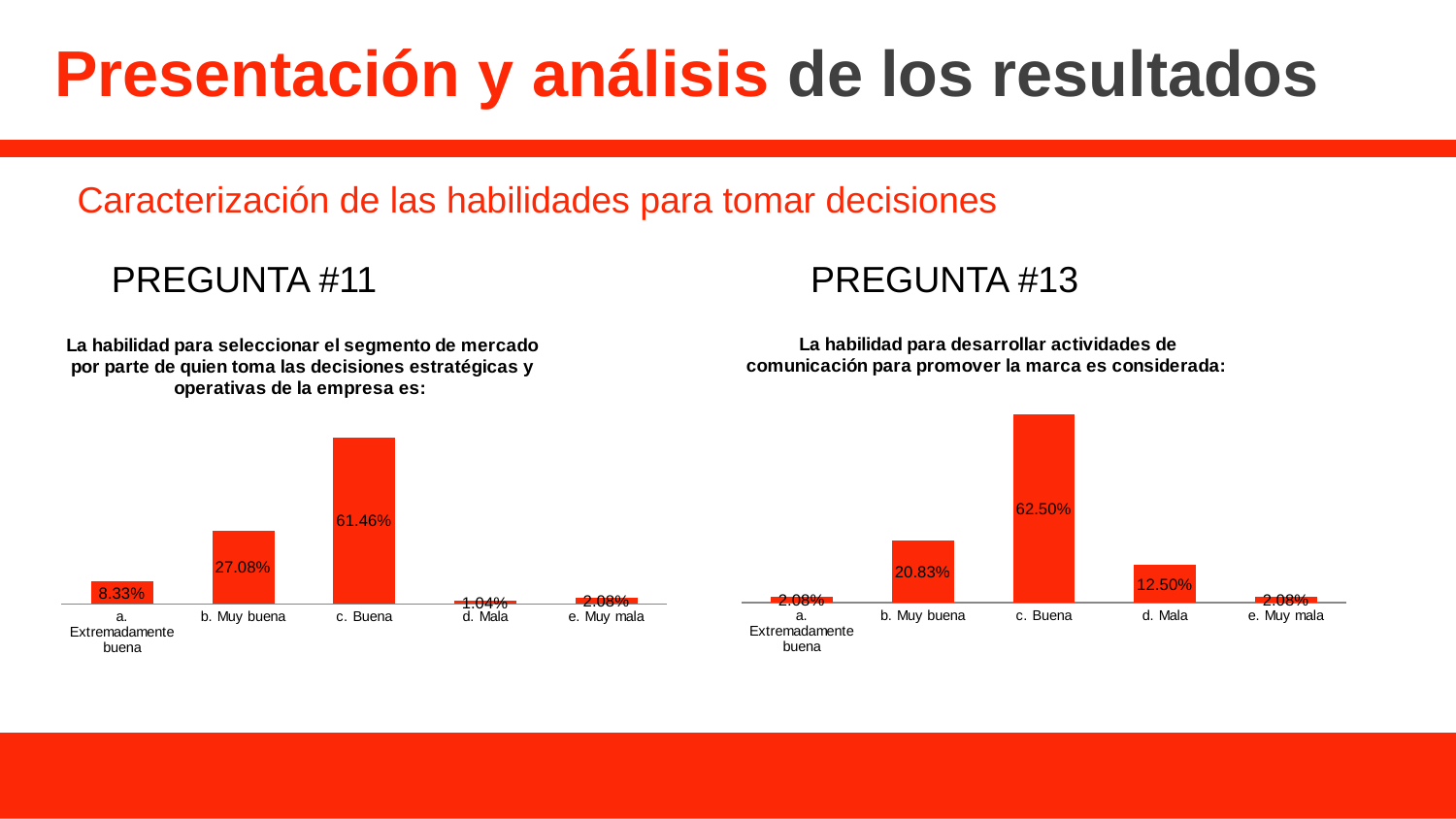
In the PREGUNTA #13 chart, what is the value for c. Buena? 62.50% In the PREGUNTA #13 chart, what is the difference between b. Muy buena and d. Mala? 8.33% In the PREGUNTA #13 chart, which category has the highest value? c. Buena How many categories does the PREGUNTA #13 chart show? 5 In the PREGUNTA #11 chart, what is the value for b. Muy buena? 27.08% In the PREGUNTA #13 chart, what is the value for d. Mala? 12.50% In the PREGUNTA #11 chart, which category has the lowest value? d. Mala In the PREGUNTA #11 chart, what is the difference between c. Buena and b. Muy buena? 34.38% In the PREGUNTA #13 chart, which is larger, b. Muy buena or d. Mala? b. Muy buena In the PREGUNTA #11 chart, what is the value for c. Buena? 61.46% In the PREGUNTA #11 chart, what is the value for a. Extremadamente buena? 8.33% What kind of chart is the PREGUNTA #11 chart? Bar chart